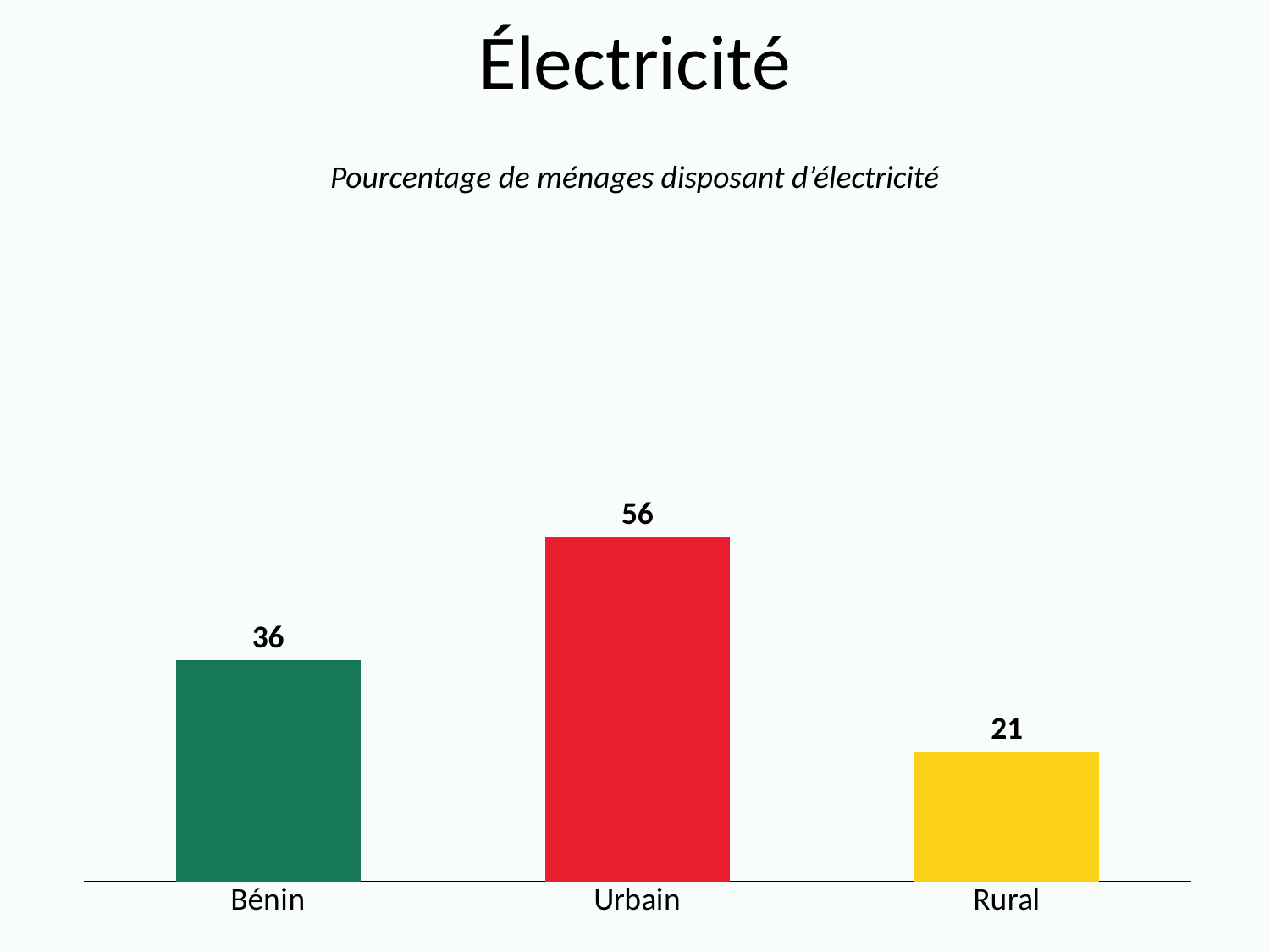
Which category has the lowest value? Rural How many categories are shown in the chart? 3 What colour is the bar for Urbain? Red What is the value for Urbain? 56 What is the value for Rural? 21 What kind of chart is shown on the slide? Bar chart What is the subtitle describing what the chart measures? Pourcentage de ménages disposant d'électricité Which is larger, the value for Bénin or the value for Rural? Bénin What is the difference between the values for Urbain and Bénin? 20 What is the value for Bénin? 36 What is the difference between the values for Urbain and Rural? 35 Which category has the highest value? Urbain